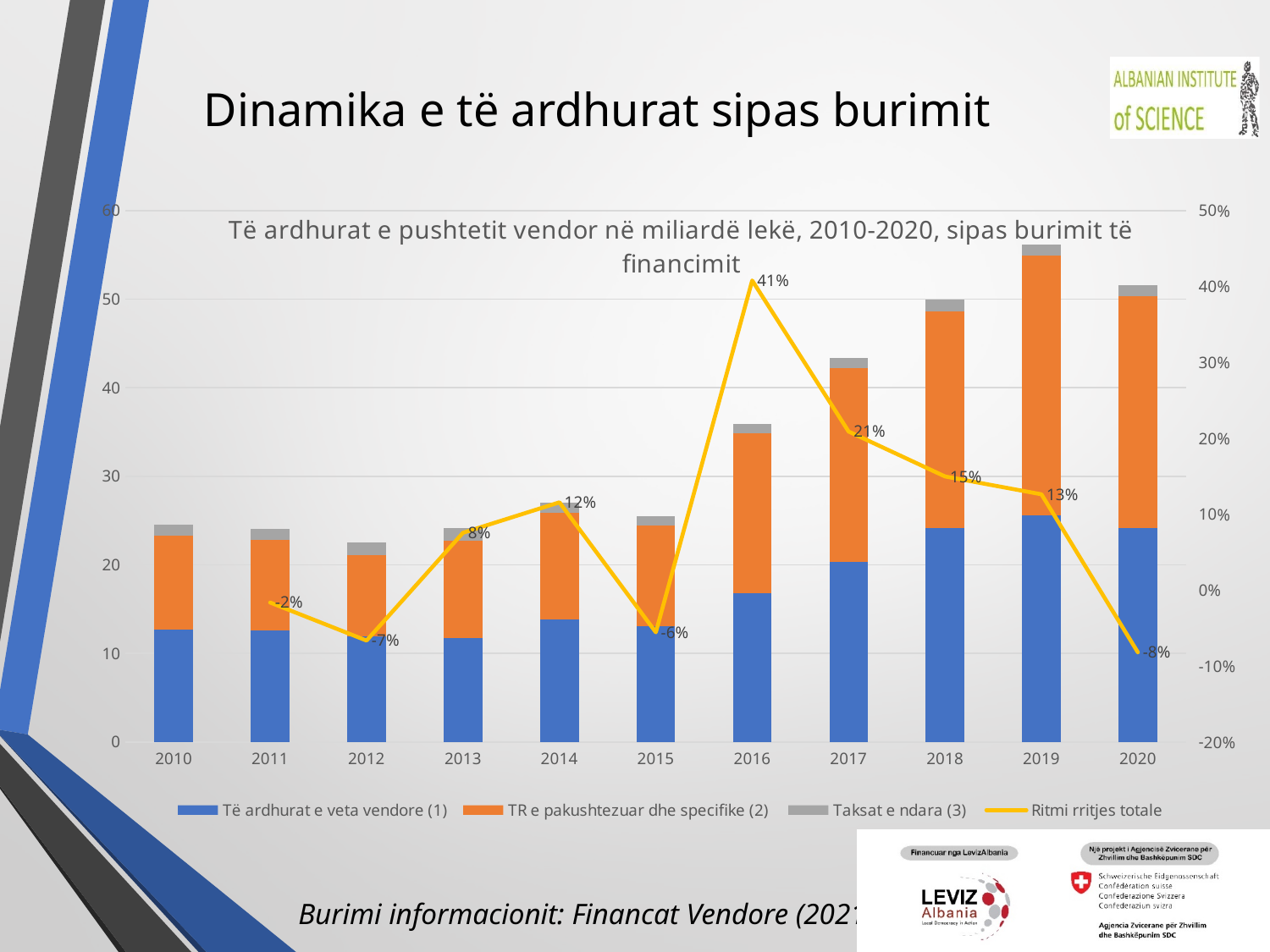
What is the value of 'Ritmi rritjes totale' for 2020? -8% In which year is 'Ritmi rritjes totale' highest? 2016 Is the total height of the stacked bar for 2019 greater or less than 50? greater What is the value of 'Ritmi rritjes totale' for 2016? 41% What is the difference between 'Ritmi rritjes totale' in 2016 and in 2017? 20 percentage points Which is larger, 'Ritmi rritjes totale' in 2014 or in 2018? 2018 Is the total height of the stacked bar for 2012 greater or less than 30? less How many years are shown on the x axis? 11 How many series does the legend list? 4 What kind of chart is shown on the slide? Combined stacked bar and line chart In which year is 'Ritmi rritjes totale' lowest? 2020 What is the value of 'Ritmi rritjes totale' for 2013? 8%